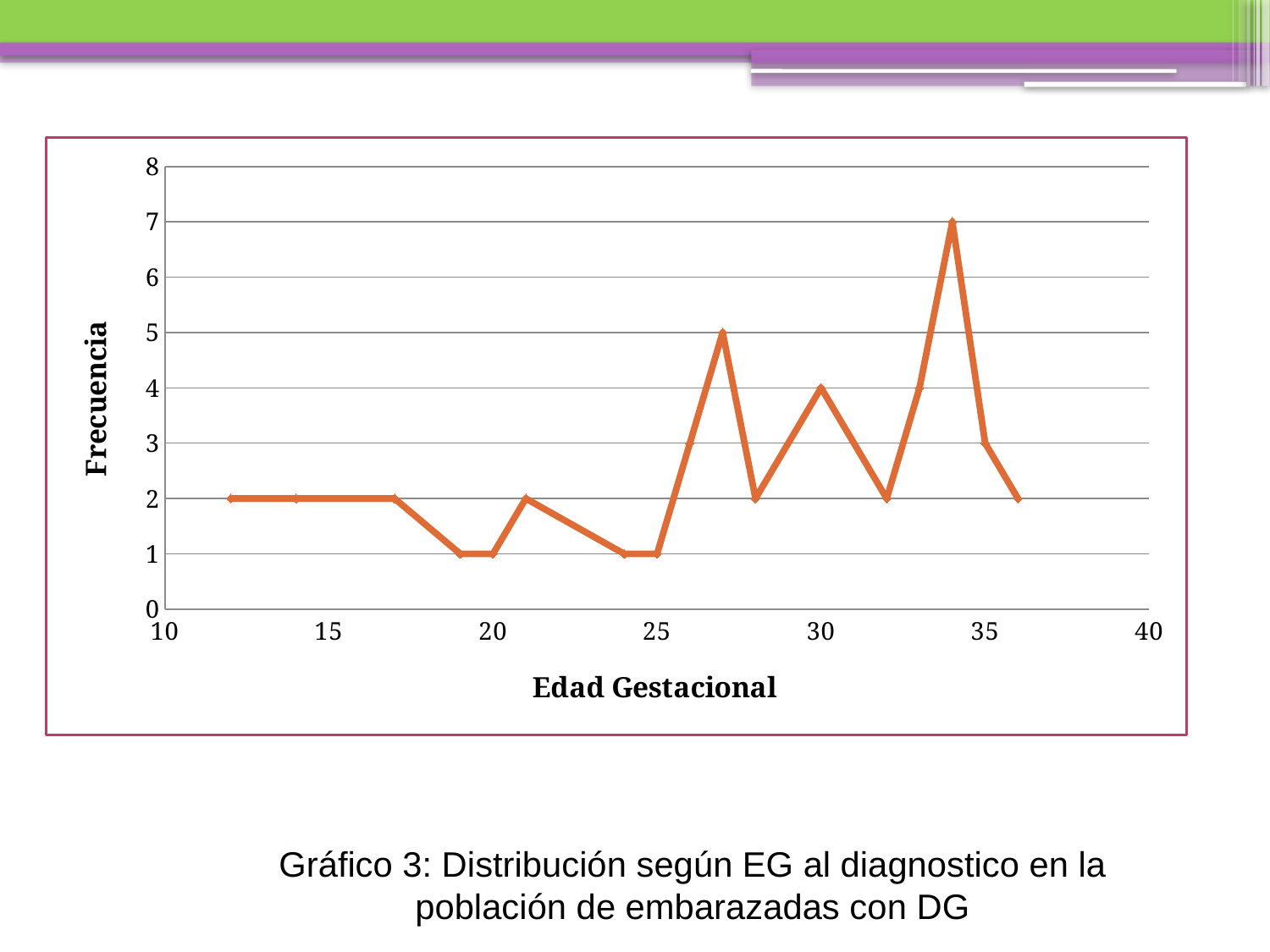
What kind of chart is shown on the slide? line chart What is the lowest frequency value reached by the line? 1 Does the line rise or fall from gestational age 35 to the last plotted point? fall What is the frequency at gestational age 35? 3 Is the peak frequency value greater or less than 6? greater Which has a higher frequency, gestational age 30 or gestational age 35? 30 What is the frequency at gestational age 25? 1 What is the title of the x axis? Edad Gestacional What is the highest frequency value reached by the line? 7 What is the frequency at gestational age 30? 4 What is the frequency at gestational age 20? 1 What is the difference between the frequency at gestational age 30 and at gestational age 35? 1